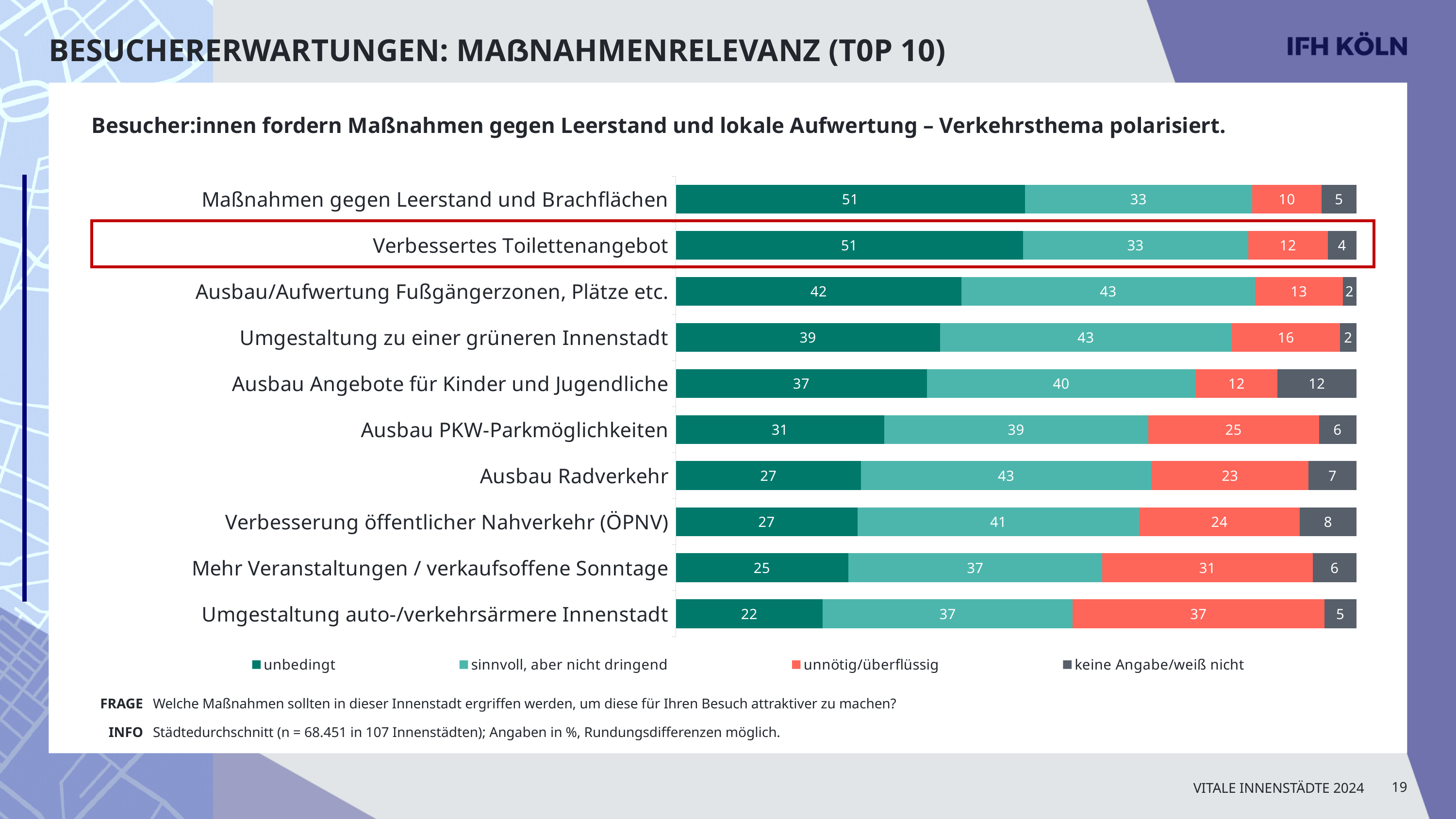
What is the 'keine Angabe/weiß nicht' value for 'Ausbau Angebote für Kinder und Jugendliche'? 12 What type of chart is shown on the slide? stacked bar chart Which has a larger 'sinnvoll, aber nicht dringend' value: 'Ausbau Radverkehr' or 'Mehr Veranstaltungen / verkaufsoffene Sonntage'? Ausbau Radverkehr What is the total of the stacked bar for 'Verbessertes Toilettenangebot'? 100 What is the 'unnötig/überflüssig' value for 'Ausbau PKW-Parkmöglichkeiten'? 25 What is the 'unbedingt' value for 'Verbessertes Toilettenangebot'? 51 Which measure has the highest 'unnötig/überflüssig' value? Umgestaltung auto-/verkehrsärmere Innenstadt How many measures (categories) are listed in the chart? 10 Which measure has the lowest 'unbedingt' value? Umgestaltung auto-/verkehrsärmere Innenstadt What is the difference between the 'unbedingt' values for 'Ausbau/Aufwertung Fußgängerzonen, Plätze etc.' and 'Ausbau Radverkehr'? 15 Which measure has the lowest 'unnötig/überflüssig' value? Maßnahmen gegen Leerstand und Brachflächen How many series does the legend list? 4